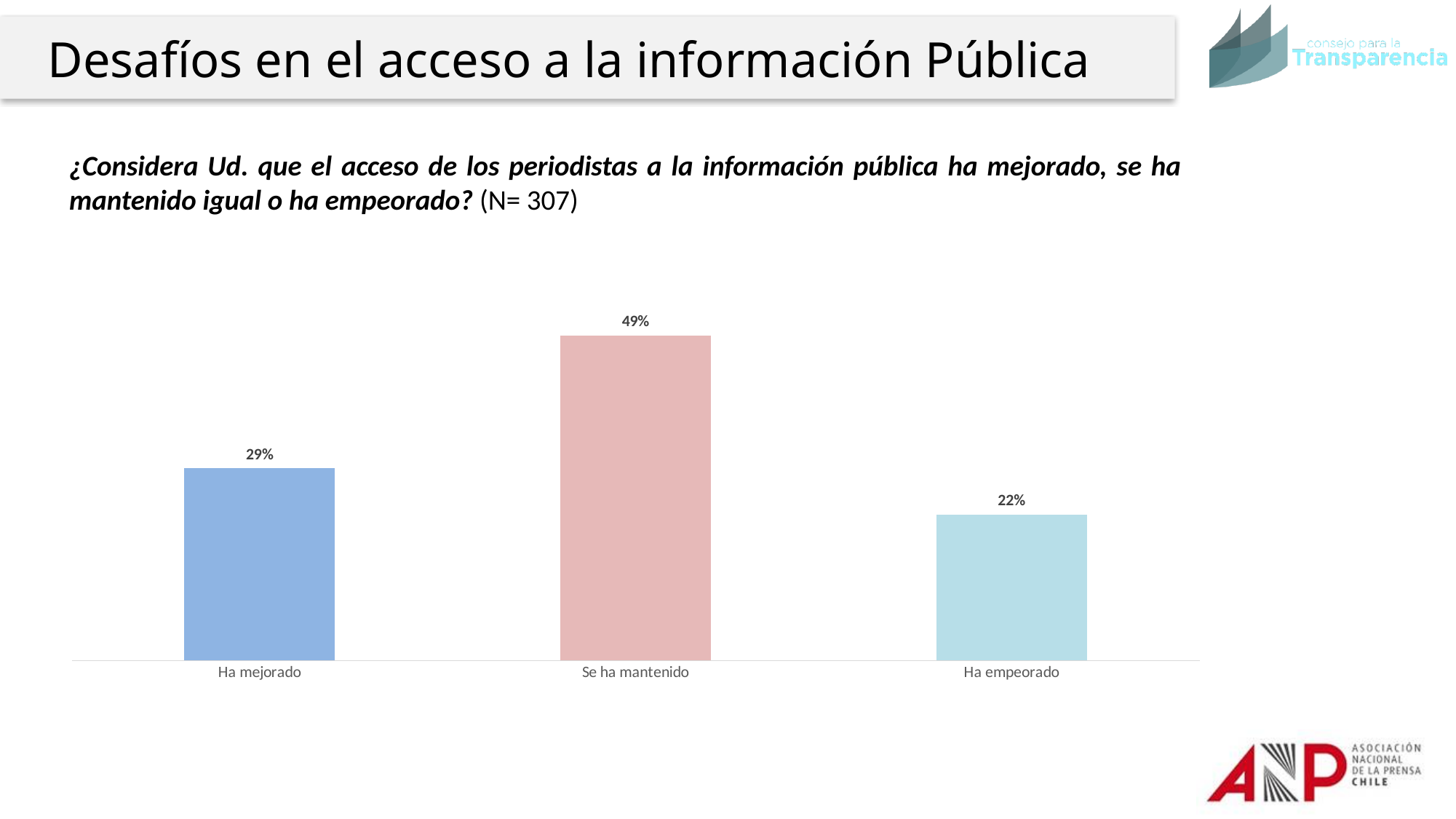
How many categories are shown in the chart? 3 What is the sample size (N) stated in the question above the chart? 307 What is the difference between the values for "Ha mejorado" and "Ha empeorado"? 7% Which category has the lowest value? Ha empeorado What kind of chart is shown on the slide? Bar chart Which is larger, the value for "Ha mejorado" or the value for "Ha empeorado"? Ha mejorado What is the value for "Ha mejorado"? 29% What colour is the bar for "Se ha mantenido"? Pink What is the value for "Ha empeorado"? 22% Which category has the highest value? Se ha mantenido What is the difference between the values for "Se ha mantenido" and "Ha mejorado"? 20% What is the value for "Se ha mantenido"? 49%